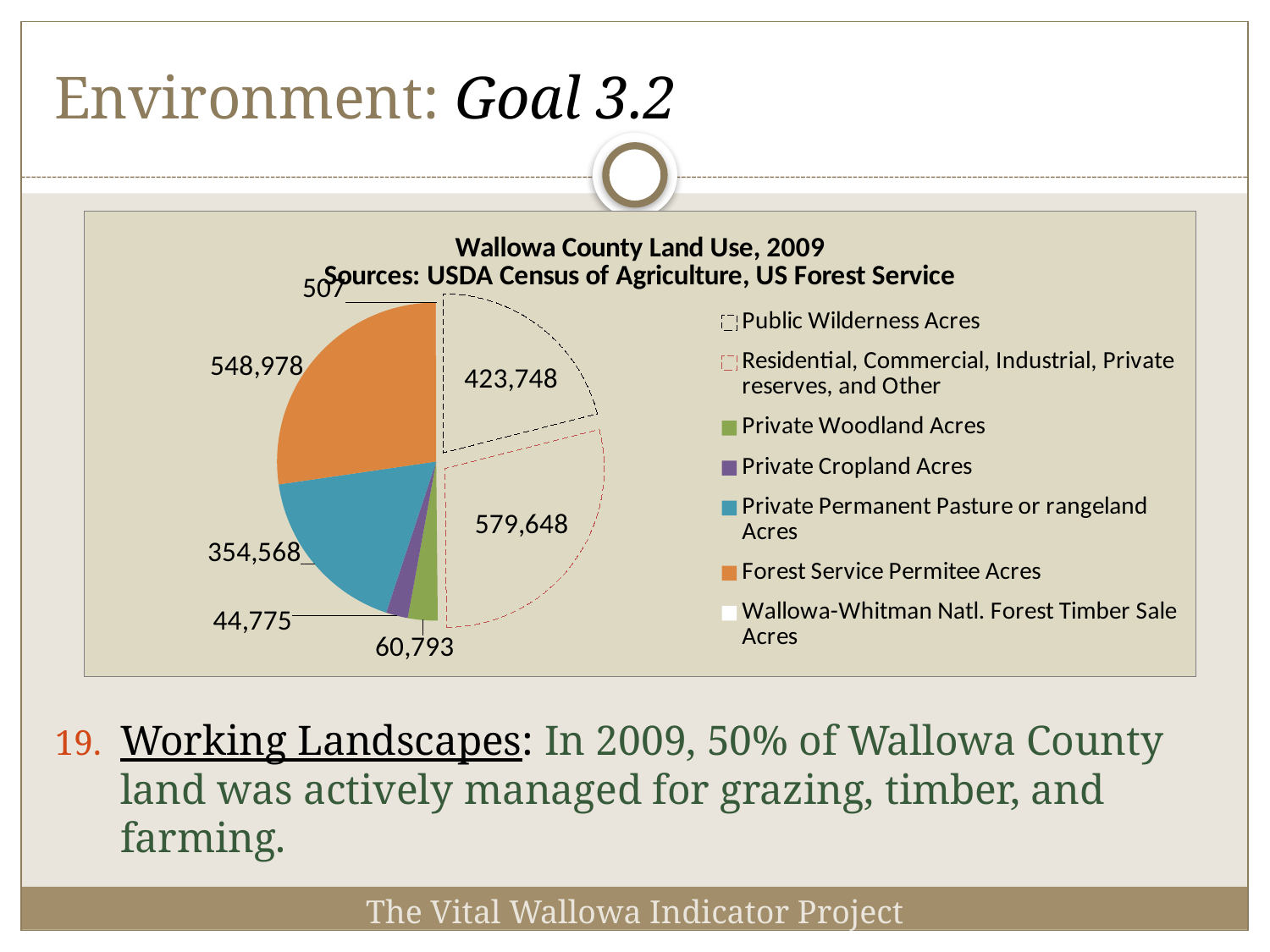
What is the difference between Public Wilderness Acres and Private Permanent Pasture or rangeland Acres? 69,180 What is the value for Wallowa-Whitman Natl. Forest Timber Sale Acres? 507 What is the title of the chart? Wallowa County Land Use, 2009 How many slices does the pie chart have? 7 What is the value for Private Cropland Acres? 44,775 Which category has the smallest slice of the pie? Wallowa-Whitman Natl. Forest Timber Sale Acres What is the value for Forest Service Permitee Acres? 548,978 What is the value for Private Permanent Pasture or rangeland Acres? 354,568 Which category has the largest slice of the pie? Residential, Commercial, Industrial, Private reserves, and Other What type of chart is shown on the slide? Pie chart What is the value for Public Wilderness Acres? 423,748 Which is larger, Forest Service Permitee Acres or Public Wilderness Acres? Forest Service Permitee Acres